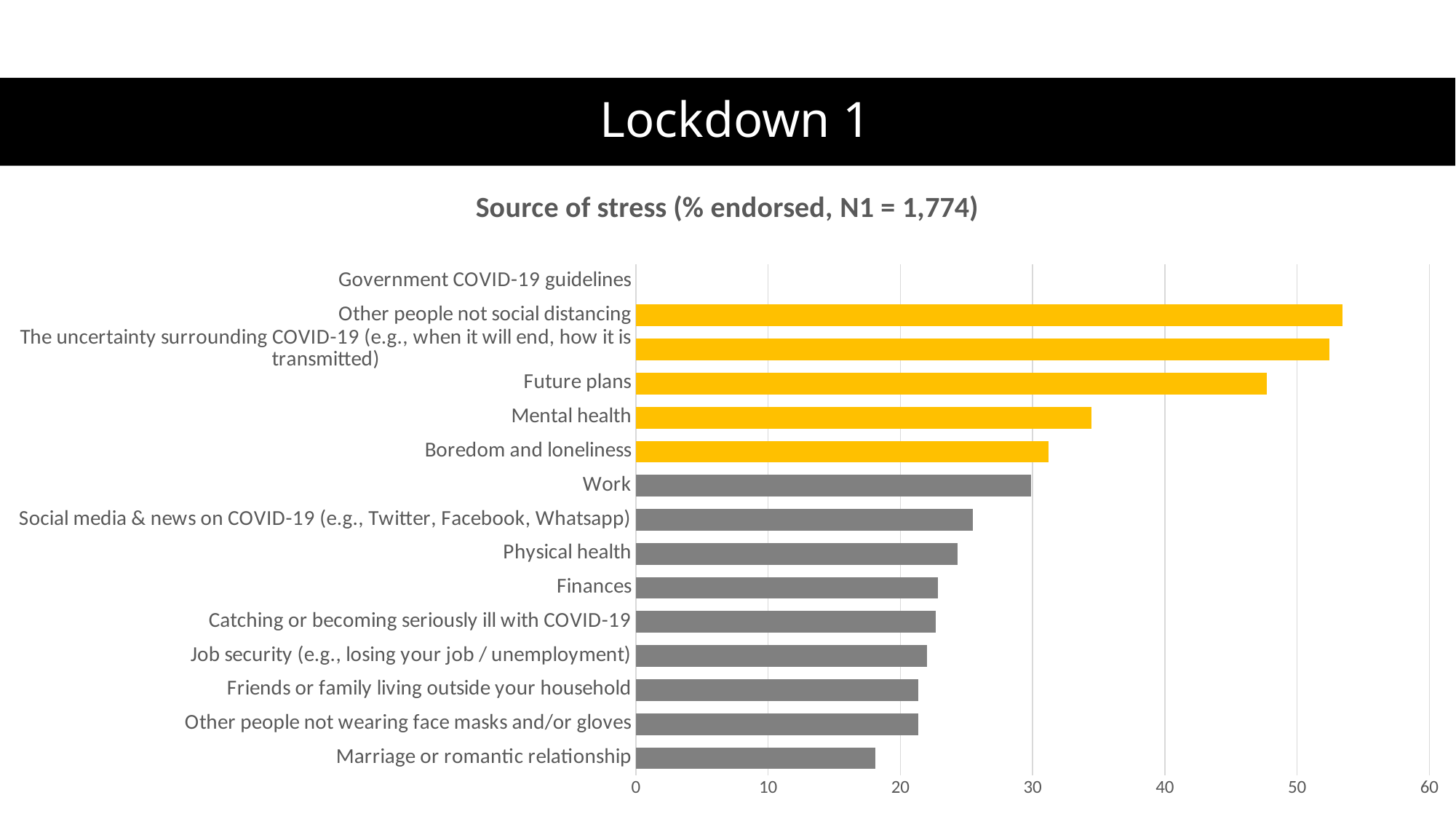
How many sources of stress are listed on the chart's category axis? 15 What kind of chart is shown on the slide? bar chart Which has the larger value, Future plans or Mental health? Future plans Which has the larger value, Work or Physical health? Work Is the value for Social media & news on COVID-19 (e.g., Twitter, Facebook, Whatsapp) greater or less than 20? greater Is the value for Mental health greater or less than 30? greater Is the value for Marriage or romantic relationship greater or less than 20? less Which has the larger value, Finances or Marriage or romantic relationship? Finances What is the title of the chart? Source of stress (% endorsed, N1 = 1,774) How many bars are coloured yellow rather than grey? 5